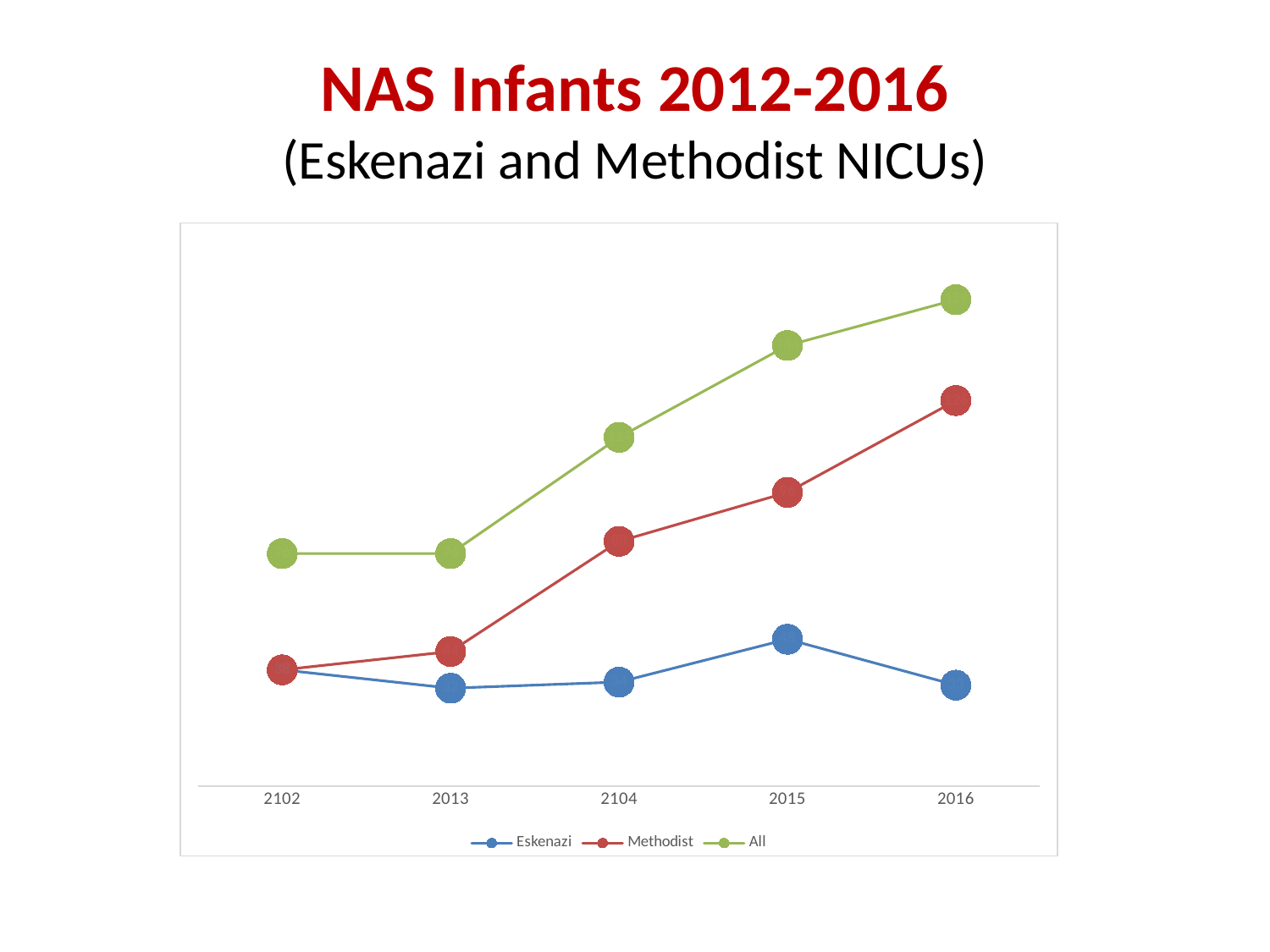
At 2016, which series is higher, Eskenazi or Methodist? Methodist How many series does the legend list? 3 How many points are plotted along the x axis for each series? 5 What kind of chart is shown on the slide? Line chart Which series is plotted in green? All Does the All series rise or fall from 2013 to 2016? Rise In which year is the All series at its highest? 2016 At 2015, which series is higher, Methodist or All? All What is the title of the slide above the chart? NAS Infants 2012-2016 In which year is the Methodist series at its lowest? 2102 Does the Methodist series rise or fall across the x axis? Rise In which year is the Eskenazi series at its highest? 2015